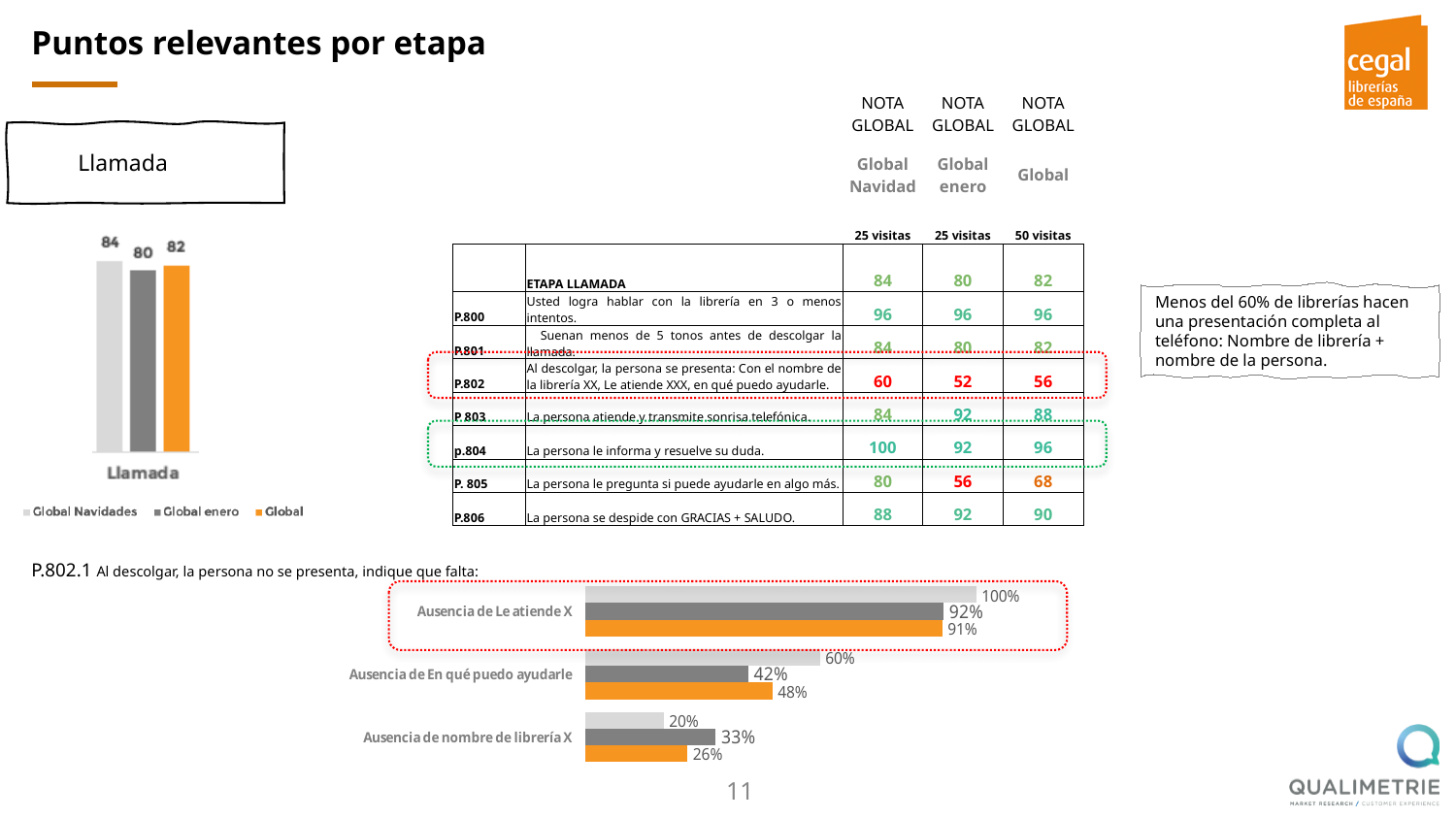
How many series does the legend of the Llamada bar chart on the left list? 3 In the P.802.1 bar chart at the bottom, how many categories are shown? 3 In the bar chart titled Llamada on the left, what is the difference between the Global Navidades value and the Global enero value? 4 In the bar chart titled Llamada on the left, what is the value for Global Navidades? 84 In the P.802.1 bar chart at the bottom, which category has the highest values overall? Ausencia de Le atiende X In the P.802.1 bar chart at the bottom, what is the value of the light grey bar for Ausencia de En qué puedo ayudarle? 60% In the bar chart titled Llamada on the left, what is the value for Global enero? 80 What kind of chart is the P.802.1 chart at the bottom of the slide? bar chart In the P.802.1 bar chart at the bottom, what is the value of the orange bar for Ausencia de Le atiende X? 91% In the P.802.1 bar chart at the bottom, what is the difference between the light grey bar and the orange bar for Ausencia de En qué puedo ayudarle? 12% In the bar chart titled Llamada on the left, which series has the lowest value? Global enero In the P.802.1 bar chart at the bottom, what is the value of the dark grey bar for Ausencia de nombre de librería X? 33%